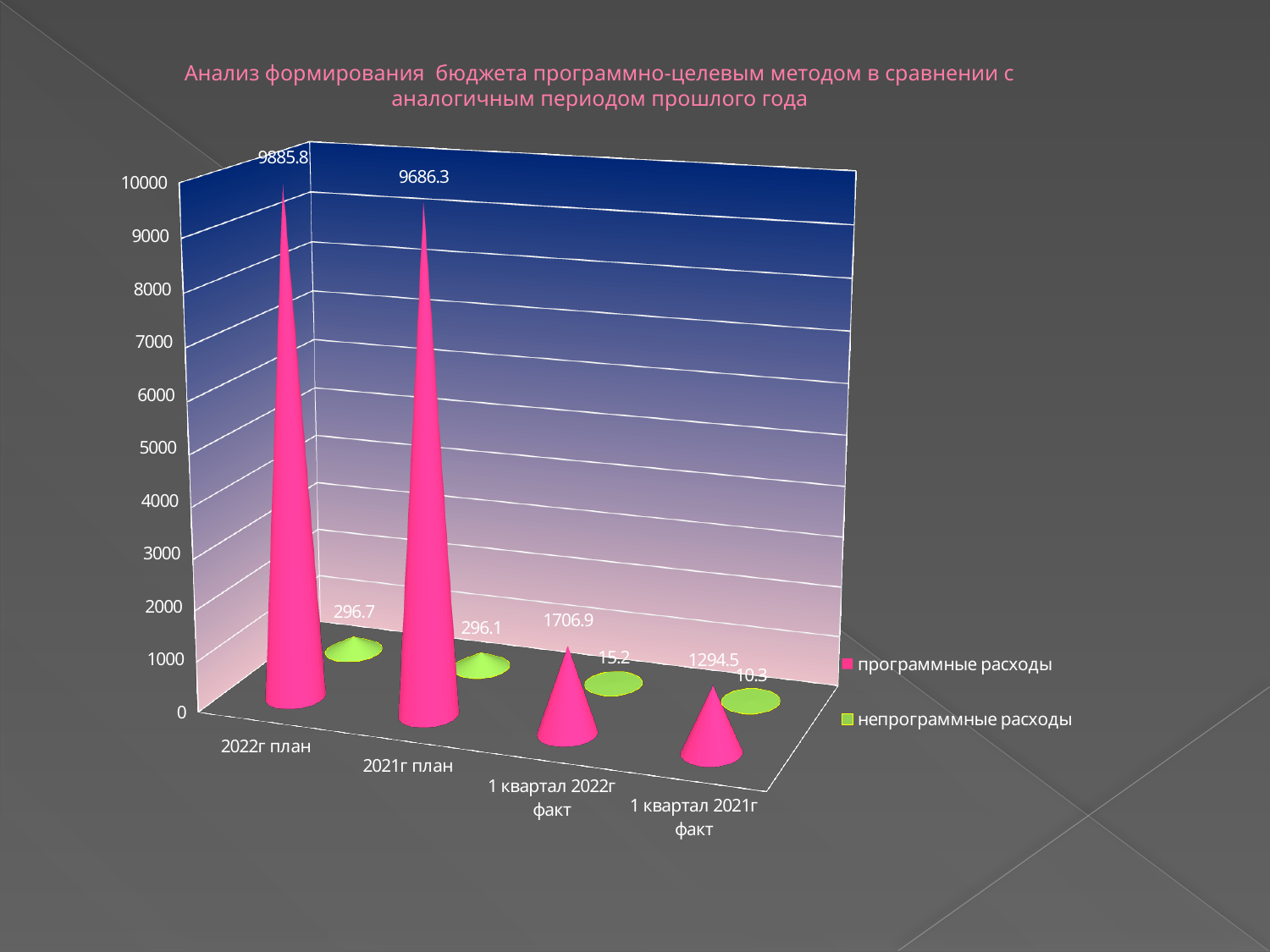
How many series does the legend list? 2 What colour represents непрограммные расходы in the chart? green What is the value of программные расходы for 2022г план? 9885.8 What is the value of программные расходы for 1 квартал 2021г факт? 1294.5 What kind of chart is shown on the slide? bar chart What is the difference between программные расходы for 2022г план and 2021г план? 199.5 What is the value of непрограммные расходы for 2021г план? 296.1 Which category has the highest value for программные расходы? 2022г план Which is larger: программные расходы for 1 квартал 2022г факт or for 1 квартал 2021г факт? 1 квартал 2022г факт Which category has the lowest value for непрограммные расходы? 1 квартал 2021г факт How many categories are shown on the x axis? 4 What is the value of непрограммные расходы for 1 квартал 2022г факт? 15.2